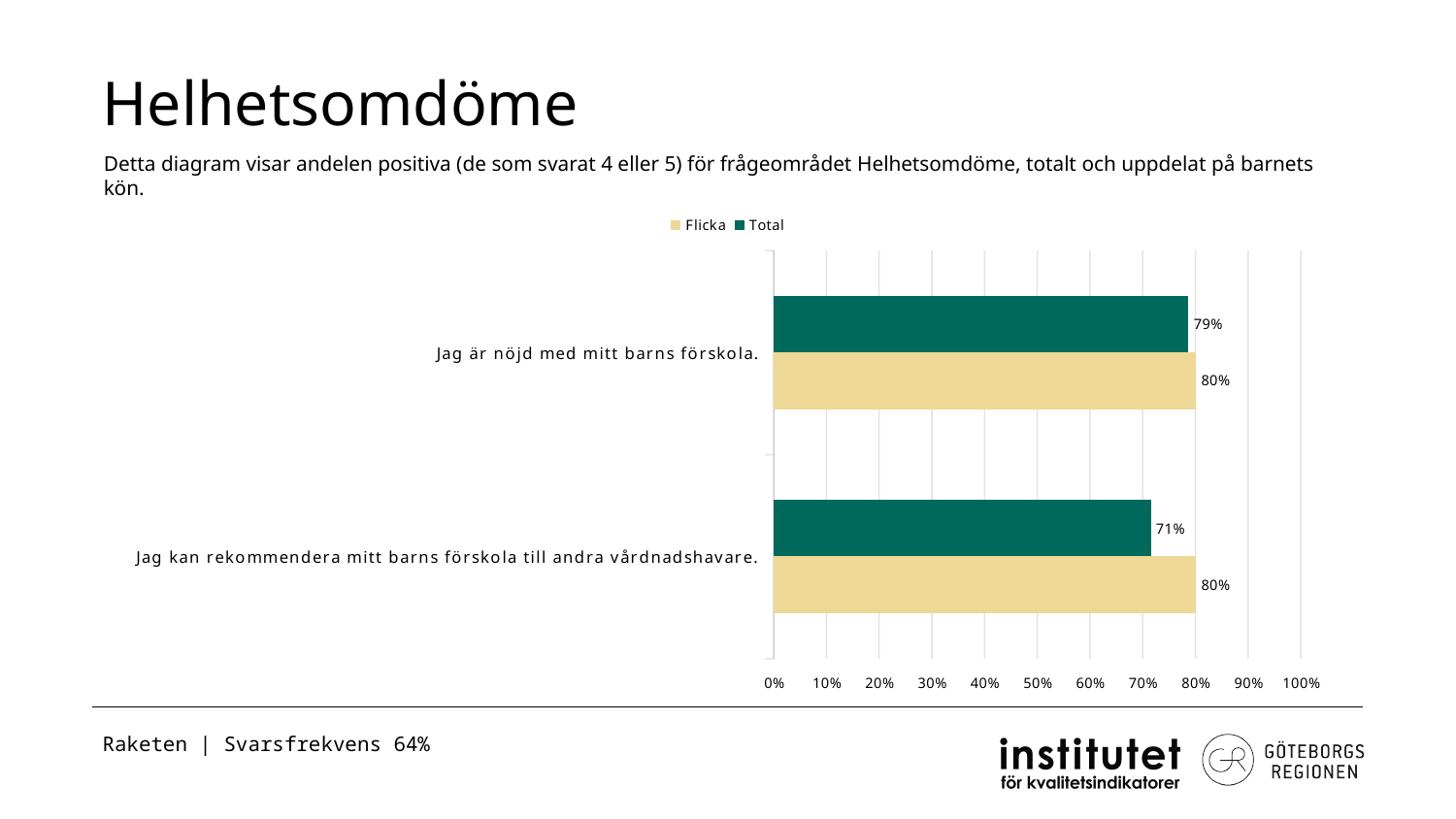
What is the Flicka value for "Jag är nöjd med mitt barns förskola."? 80% Is the Total value for "Jag kan rekommendera mitt barns förskola till andra vårdnadshavare." greater or less than 80%? less What is the Total value for "Jag kan rekommendera mitt barns förskola till andra vårdnadshavare."? 71% How many series does the legend list? 2 How many categories are shown on the chart? 2 What is the Total value for "Jag är nöjd med mitt barns förskola."? 79% For "Jag kan rekommendera mitt barns förskola till andra vårdnadshavare.", which is larger, the Flicka value or the Total value? Flicka Which category has the lowest Total value? Jag kan rekommendera mitt barns förskola till andra vårdnadshavare. What is the difference between the Flicka and Total values for "Jag kan rekommendera mitt barns förskola till andra vårdnadshavare."? 9 percentage points What is the Flicka value for "Jag kan rekommendera mitt barns förskola till andra vårdnadshavare."? 80% What kind of chart is shown on the slide? Bar chart What is the difference between the Total values for the two categories? 8 percentage points